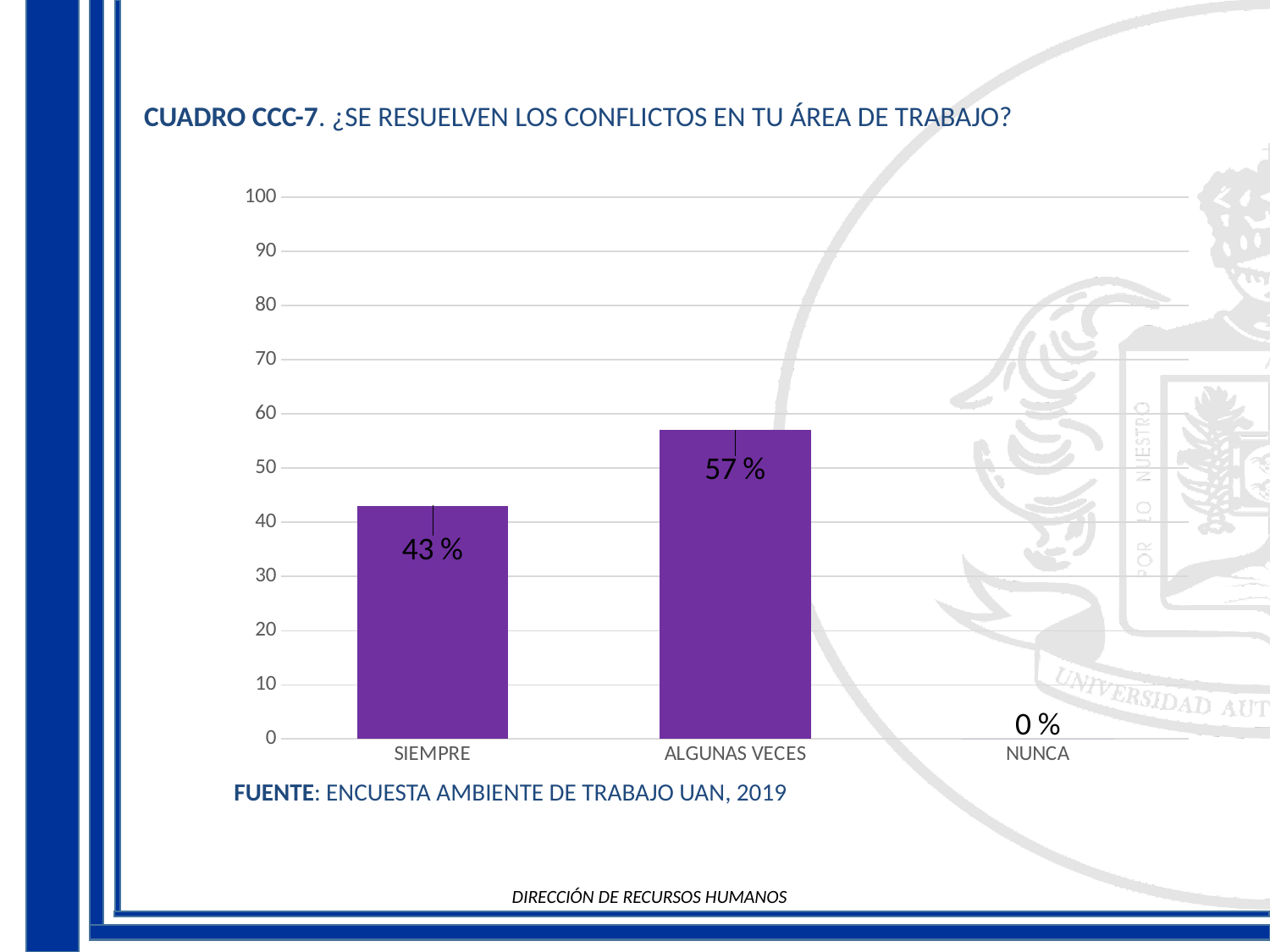
What is the value for SIEMPRE? 43 % What is the value for NUNCA? 0 % How many categories are shown on the x axis? 3 Which is larger, the value for SIEMPRE or the value for ALGUNAS VECES? ALGUNAS VECES Is the value for SIEMPRE greater or less than 50? less What is the value for ALGUNAS VECES? 57 % What is the source cited below the chart? ENCUESTA AMBIENTE DE TRABAJO UAN, 2019 Which category has the highest value? ALGUNAS VECES Is the value for ALGUNAS VECES greater or less than 50? greater Which category has the lowest value? NUNCA What kind of chart is shown on the slide? bar chart What is the difference between the values for ALGUNAS VECES and SIEMPRE? 14 %